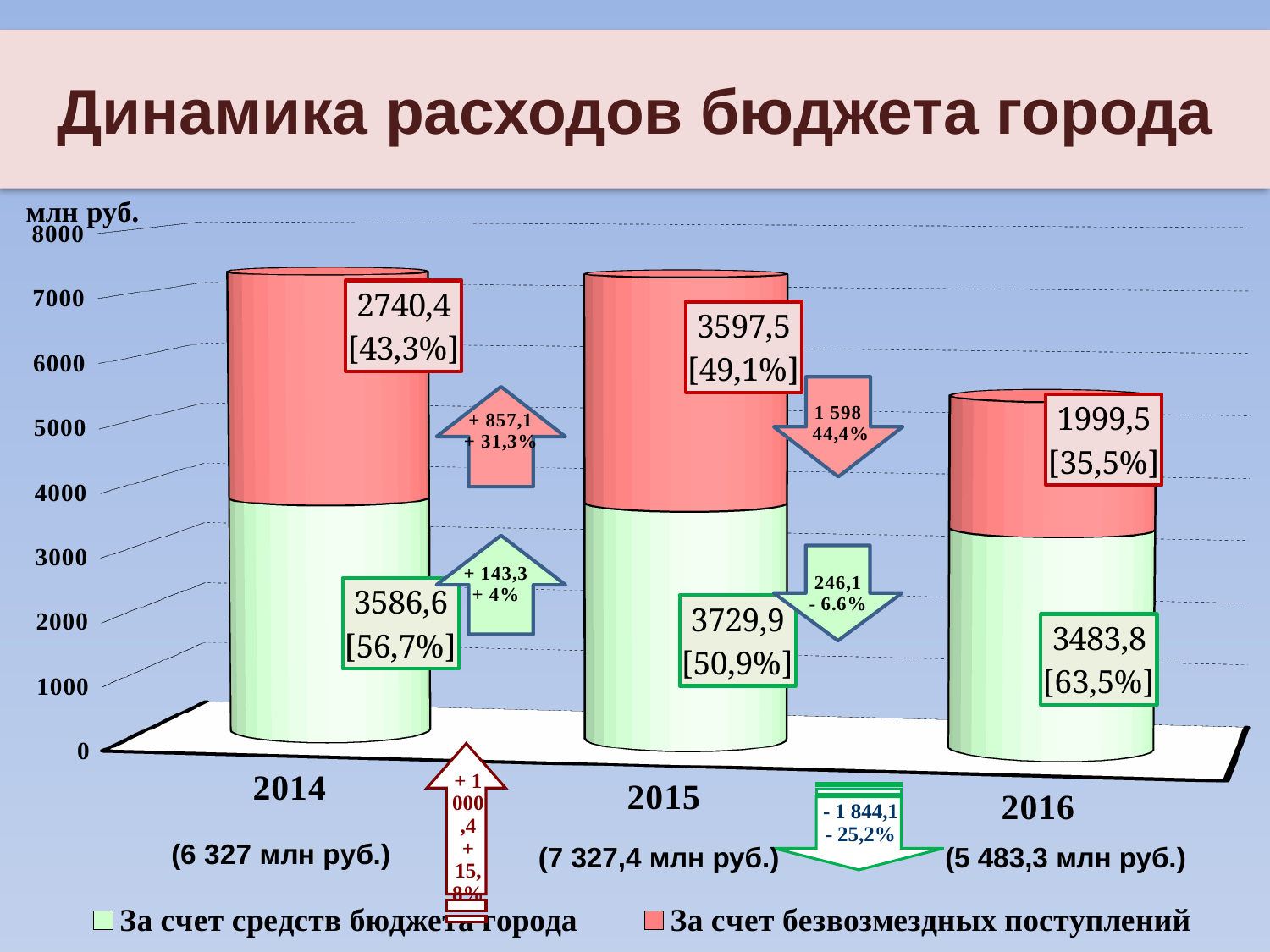
What is the total budget expenditure shown for 2015? 7 327,4 млн руб. What type of chart is shown on the slide? stacked bar chart What is the title of the chart on the slide? Динамика расходов бюджета города In which year is the value of 'За счет безвозмездных поступлений' the highest? 2015 In which year is the value of 'За счет средств бюджета города' the lowest? 2016 What is the value of 'За счет безвозмездных поступлений' for 2014? 2740,4 How many series does the chart legend list? 2 How many years (categories) are shown on the x axis of the chart? 3 Which is larger in 2014: 'За счет средств бюджета города' or 'За счет безвозмездных поступлений'? За счет средств бюджета города What is the value of 'За счет безвозмездных поступлений' for 2016? 1999,5 What is the value of 'За счет средств бюджета города' for 2015? 3729,9 What percentage share is shown for 'За счет средств бюджета города' in 2016? 63,5%